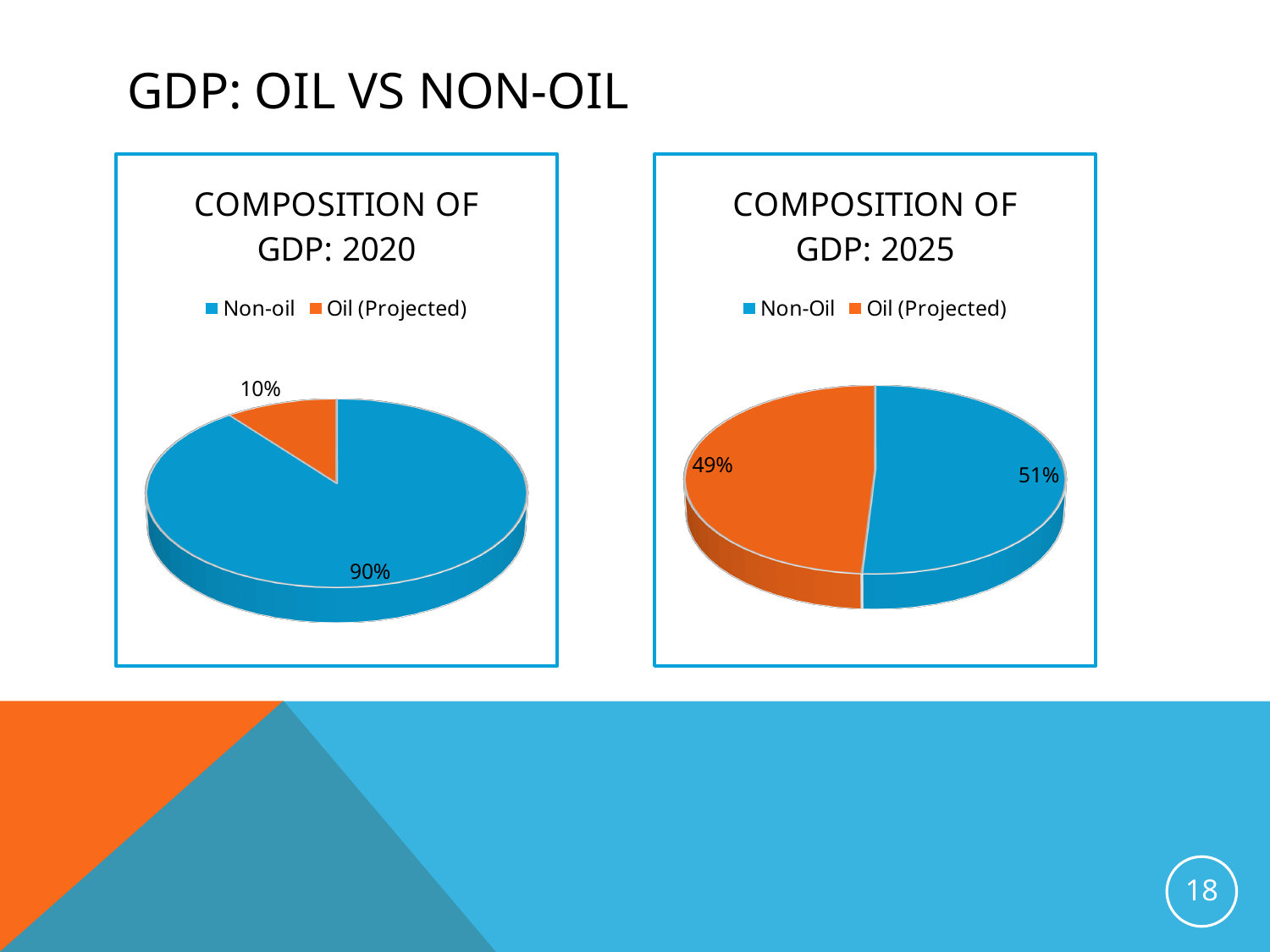
In the 'Composition of GDP: 2025' chart, what share of GDP is Oil (Projected)? 49% What type of chart is the 'Composition of GDP: 2025' chart? Pie chart How many slices does the 'Composition of GDP: 2020' pie chart have? 2 In the 'Composition of GDP: 2025' chart, what share of GDP is Non-Oil? 51% In the 'Composition of GDP: 2020' chart, what share of GDP is Oil (Projected)? 10% How many series does the legend of the 'Composition of GDP: 2025' chart list? 2 In the 'Composition of GDP: 2020' chart, what share of GDP is Non-oil? 90% In the 'Composition of GDP: 2020' chart, which slice is the smallest? Oil (Projected) In the 'Composition of GDP: 2025' chart, what colour is the Oil (Projected) slice? Orange In the 'Composition of GDP: 2020' chart, what is the difference between the Non-oil and Oil (Projected) shares? 80% In the 'Composition of GDP: 2020' chart, which slice is the largest? Non-oil In the 'Composition of GDP: 2025' chart, what is the difference between the Non-Oil and Oil (Projected) shares? 2%